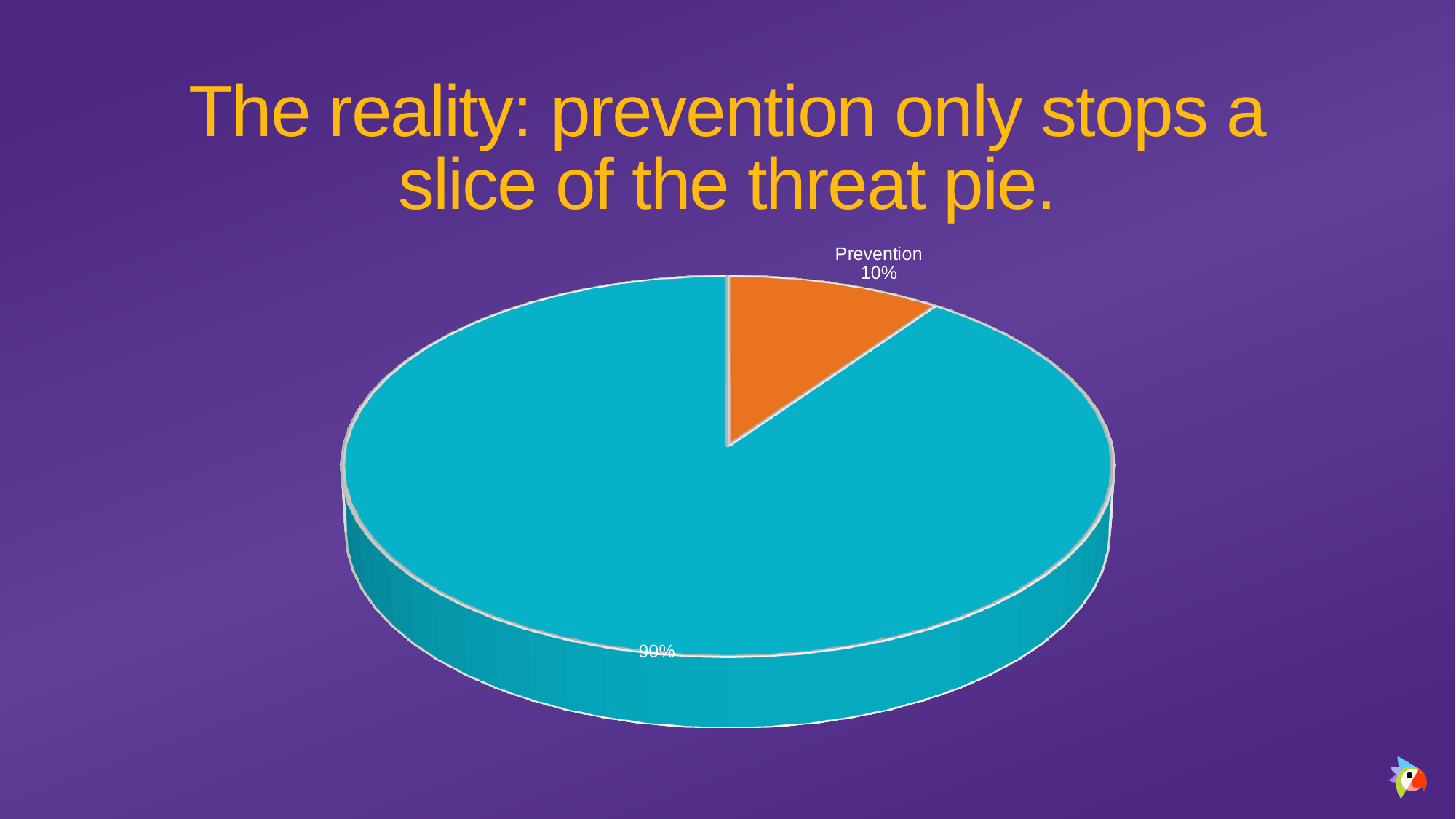
Is the Prevention slice the largest or the smallest slice of the pie? smallest What is the title of the slide containing the pie chart? The reality: prevention only stops a slice of the threat pie. How many slices does the pie chart have? 2 Is the share of the Prevention slice greater or less than 50%? less What percentage is shown on the larger, unlabeled slice of the pie? 90% What kind of chart is shown on the slide? pie chart Which slice is larger: the Prevention slice or the teal slice? the teal slice By how many percentage points does the larger slice exceed the Prevention slice? 80 percentage points What share of the pie does the Prevention slice represent? 10% What colour is the Prevention slice? orange